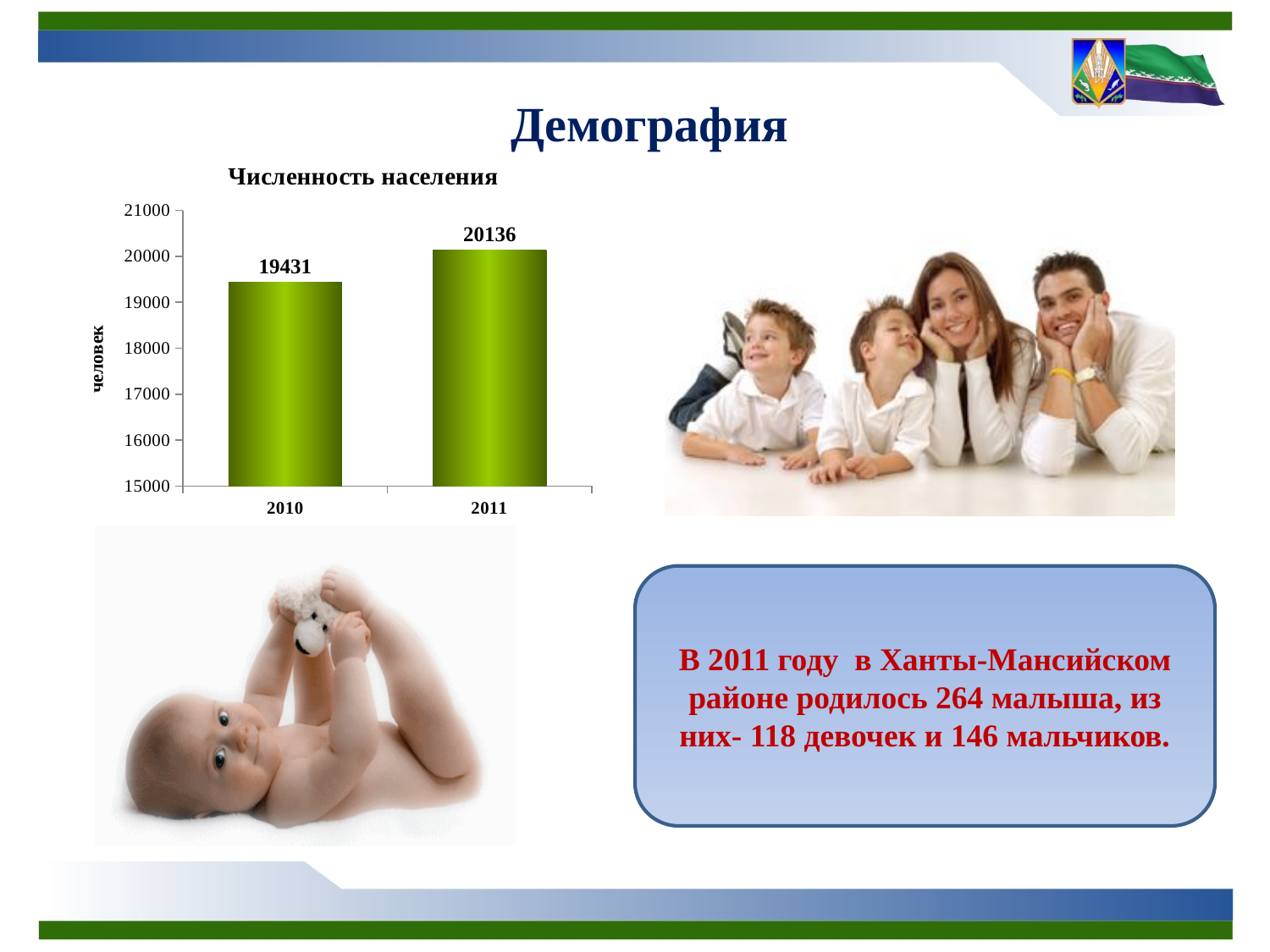
What is the difference between the 2011 and 2010 population values? 705 What is the population value shown for 2011? 20136 Which year has the lower population value? 2010 What kind of chart is used to show the population? bar chart Is the value for 2010 greater or less than 20000? less Does the population rise or fall from 2010 to 2011? rise What is the title of the chart? Численность населения Which year has the higher population value? 2011 What is the label on the vertical axis of the chart? человек Is the value for 2011 greater or less than 20000? greater What is the population value shown for 2010? 19431 How many years are shown on the x axis of the chart? 2